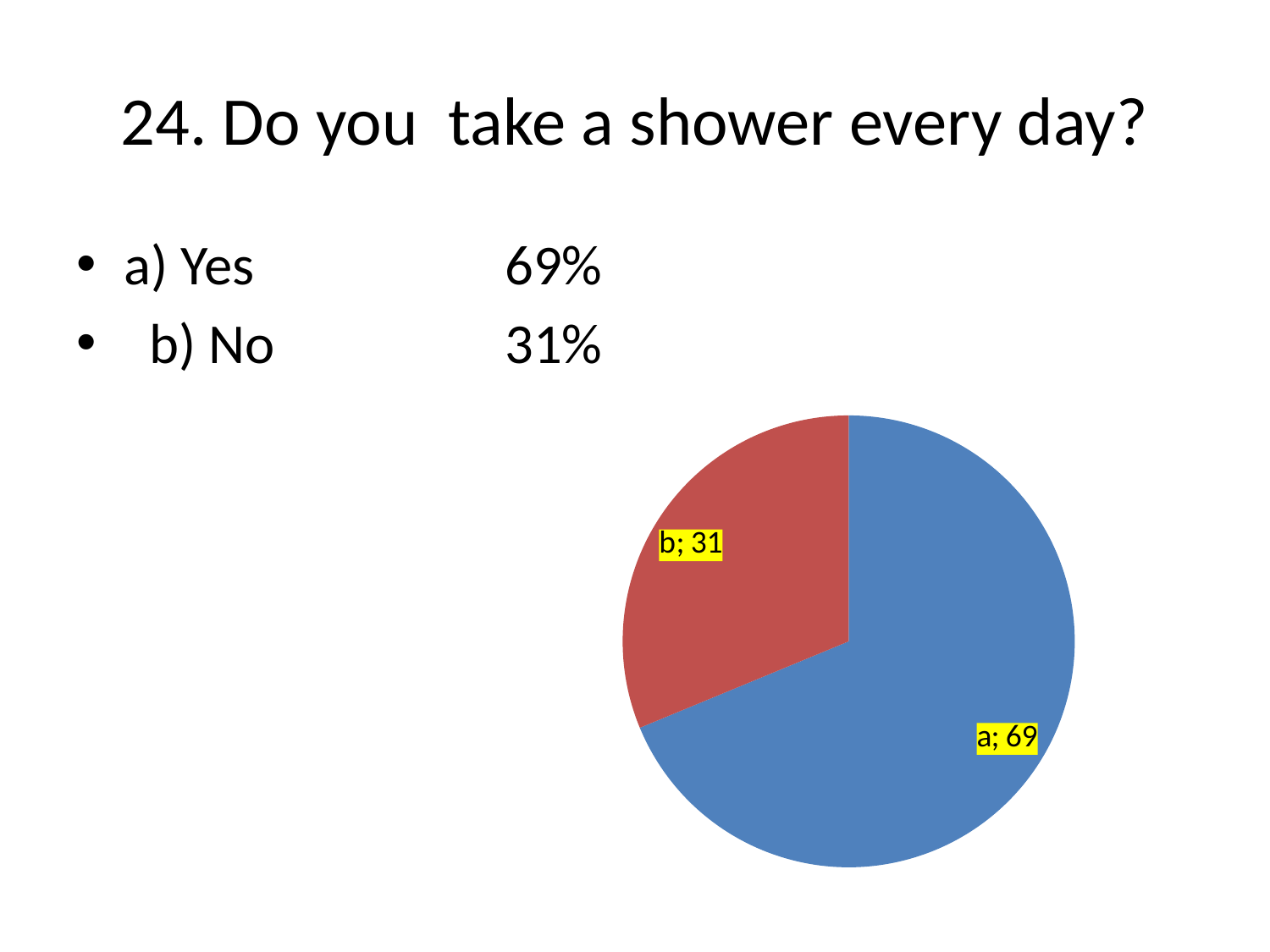
What is the value shown for slice b in the pie chart? 31 What colour is slice a in the pie chart? blue What colour is slice b in the pie chart? red Which is larger, the value for slice a or slice b? a Which slice of the pie chart is the largest? a What share of the pie does slice a represent? 69% What is the difference between the values for slice a and slice b? 38 What share of the pie does slice b represent? 31% What kind of chart is shown on the slide? pie chart Which slice of the pie chart is the smallest? b What is the value shown for slice a in the pie chart? 69 How many slices does the pie chart have? 2